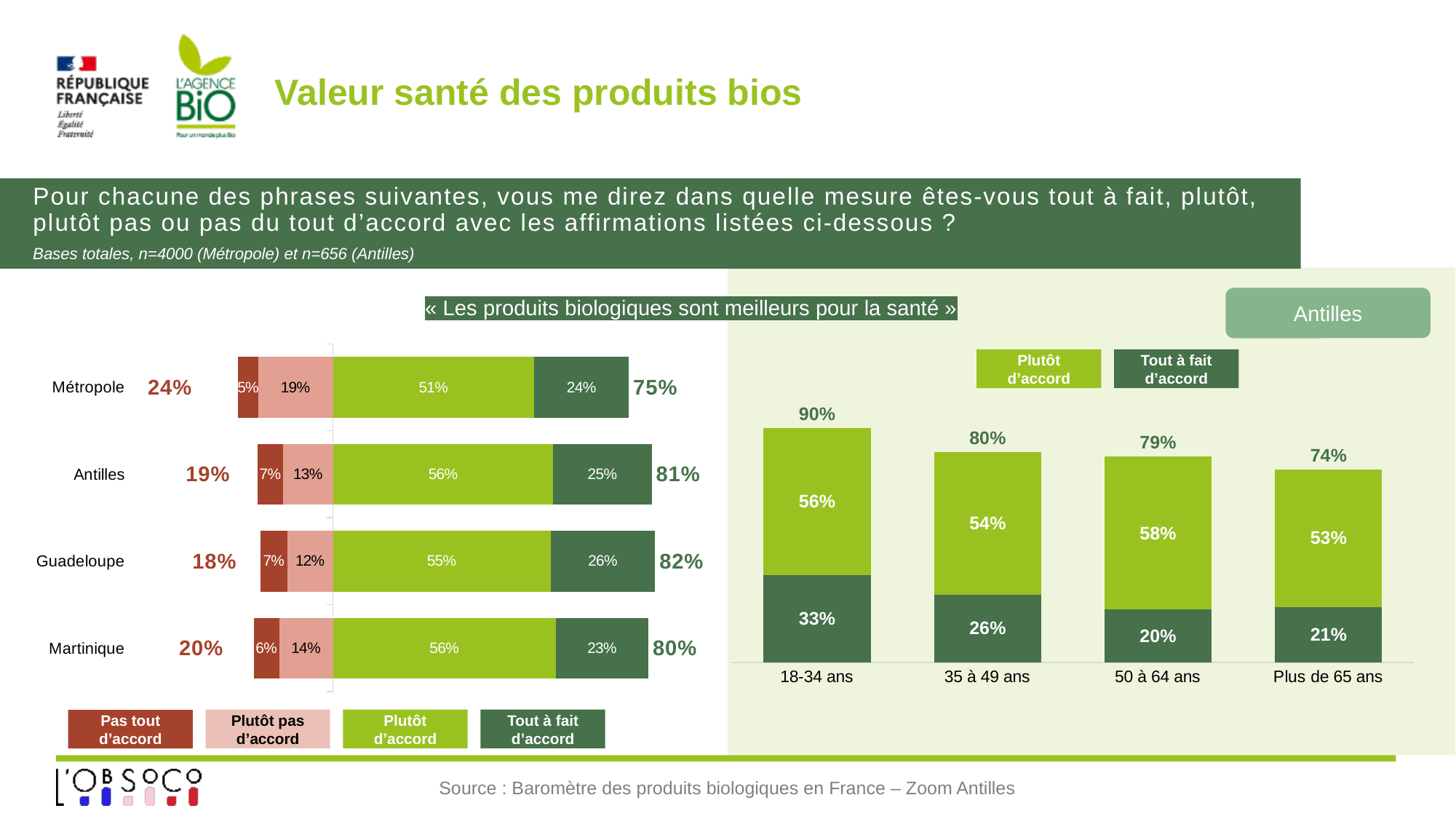
In the left chart by region, what is the difference between the total agreement for Antilles and for Métropole? 6 points In the left chart by region, what percentage of Métropole respondents answered "Plutôt d'accord"? 51% In the left chart by region, which region has the highest total agreement (Plutôt + Tout à fait d'accord)? Guadeloupe In the left chart by region, what is the "Tout à fait d'accord" value for Guadeloupe? 26% In the left chart by region, how many response categories does the legend list? 4 In the right chart by age group (Antilles), which age group has the highest total agreement? 18-34 ans What kind of chart is the right chart by age group (Antilles)? Stacked bar chart In the right chart by age group (Antilles), what is the "Tout à fait d'accord" value for 18-34 ans? 33% In the right chart by age group (Antilles), what is the total agreement for Plus de 65 ans? 74% In the left chart by region, how many regions are shown? 4 In the left chart by region, which region has the lowest total agreement? Métropole In the right chart by age group (Antilles), is the "Plutôt d'accord" value for 50 à 64 ans larger or smaller than for 35 à 49 ans? larger